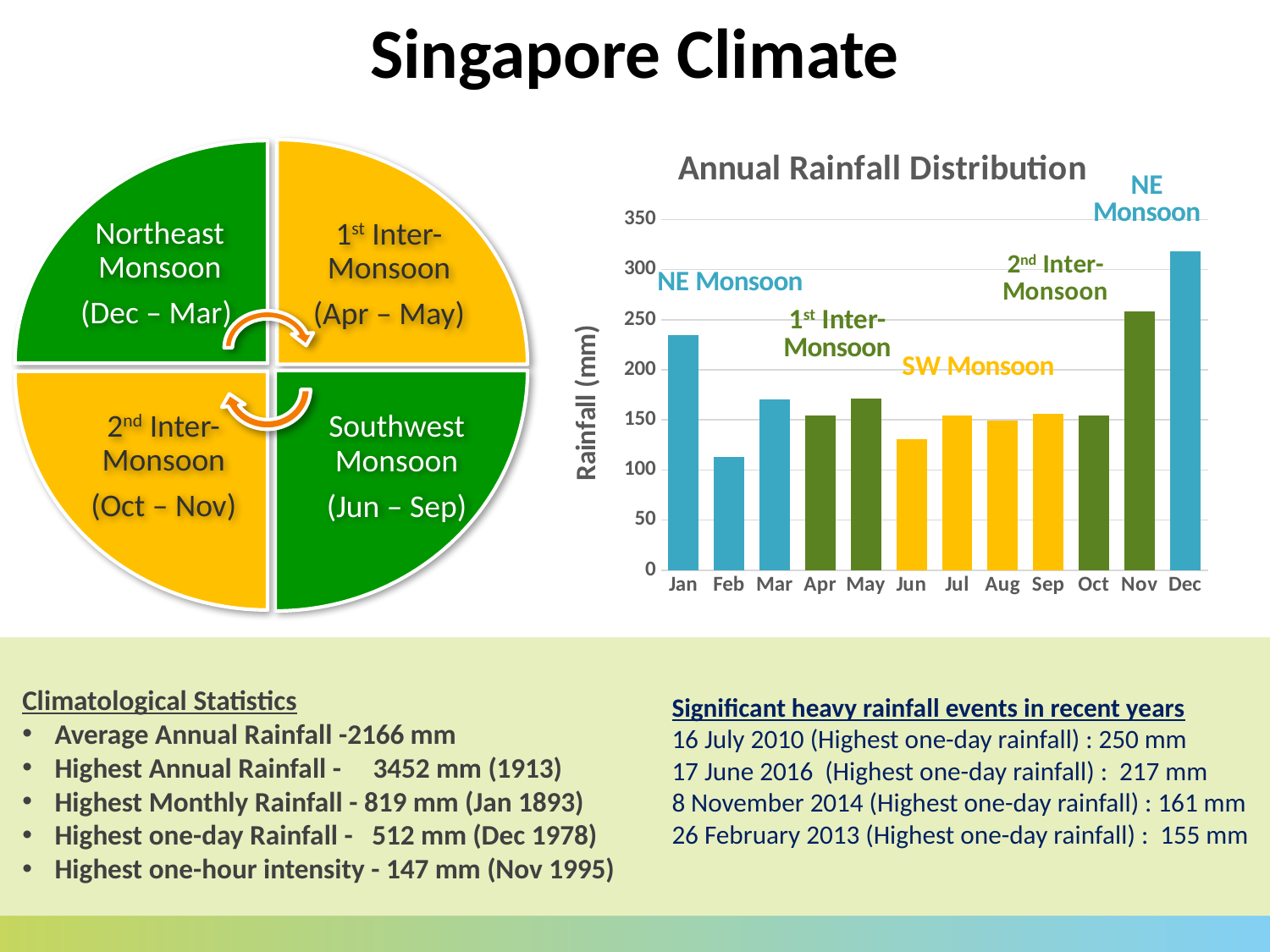
Which month has the highest rainfall in the Annual Rainfall Distribution chart? Dec In the Annual Rainfall Distribution chart, is the rainfall for Feb greater or less than 150? less What is the title of the chart on the slide? Annual Rainfall Distribution In the Annual Rainfall Distribution chart, is the rainfall for Jan greater or less than 200? greater In the Annual Rainfall Distribution chart, is the rainfall for Jun greater or less than 150? less Which month has the lowest rainfall in the Annual Rainfall Distribution chart? Feb What is the label on the vertical axis of the Annual Rainfall Distribution chart? Rainfall (mm) How many months are plotted in the Annual Rainfall Distribution chart? 12 In the Annual Rainfall Distribution chart, which month has more rainfall, Jan or Nov? Nov In the Annual Rainfall Distribution chart, does rainfall rise or fall from Sep to Dec? rise What kind of chart is the Annual Rainfall Distribution chart? bar chart